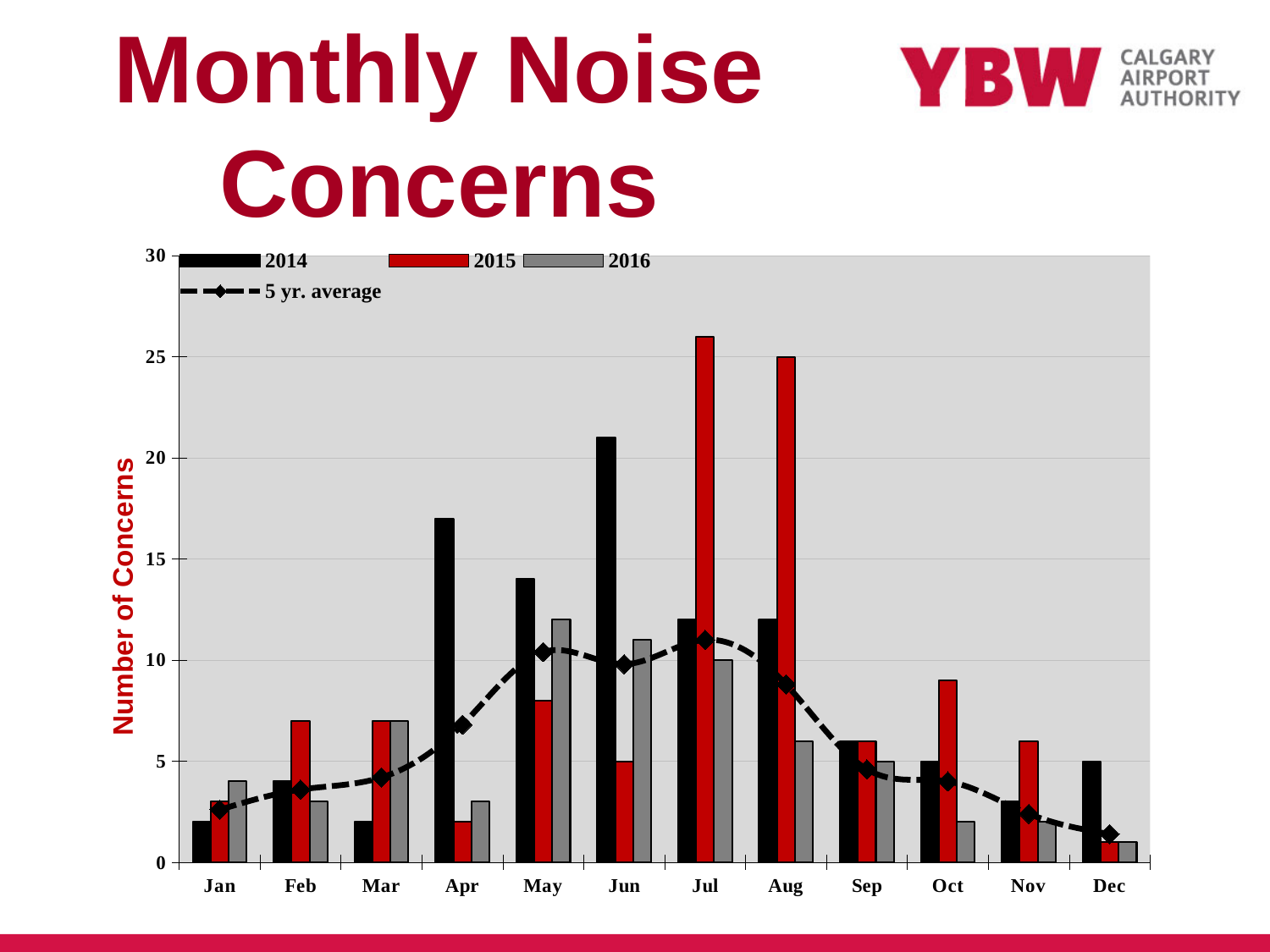
Which month has the highest 2014 bar? Jun Which is larger in Apr, the 2014 bar or the 2015 bar? 2014 Is the 2016 value for Jan greater or less than 5? less Is the 2015 value for Jul greater or less than 25? greater What kind of chart is shown on the slide? bar and line chart Does the 5 yr. average line rise or fall from Aug to Dec? fall What is the y-axis title of the chart? Number of Concerns Which series is drawn as a dashed line with diamond markers? 5 yr. average Which is larger in Jul, the 2014 bar or the 2015 bar? 2015 Is the 2014 value for Apr greater or less than 15? greater How many series does the legend list? 4 How many months are shown along the x axis? 12